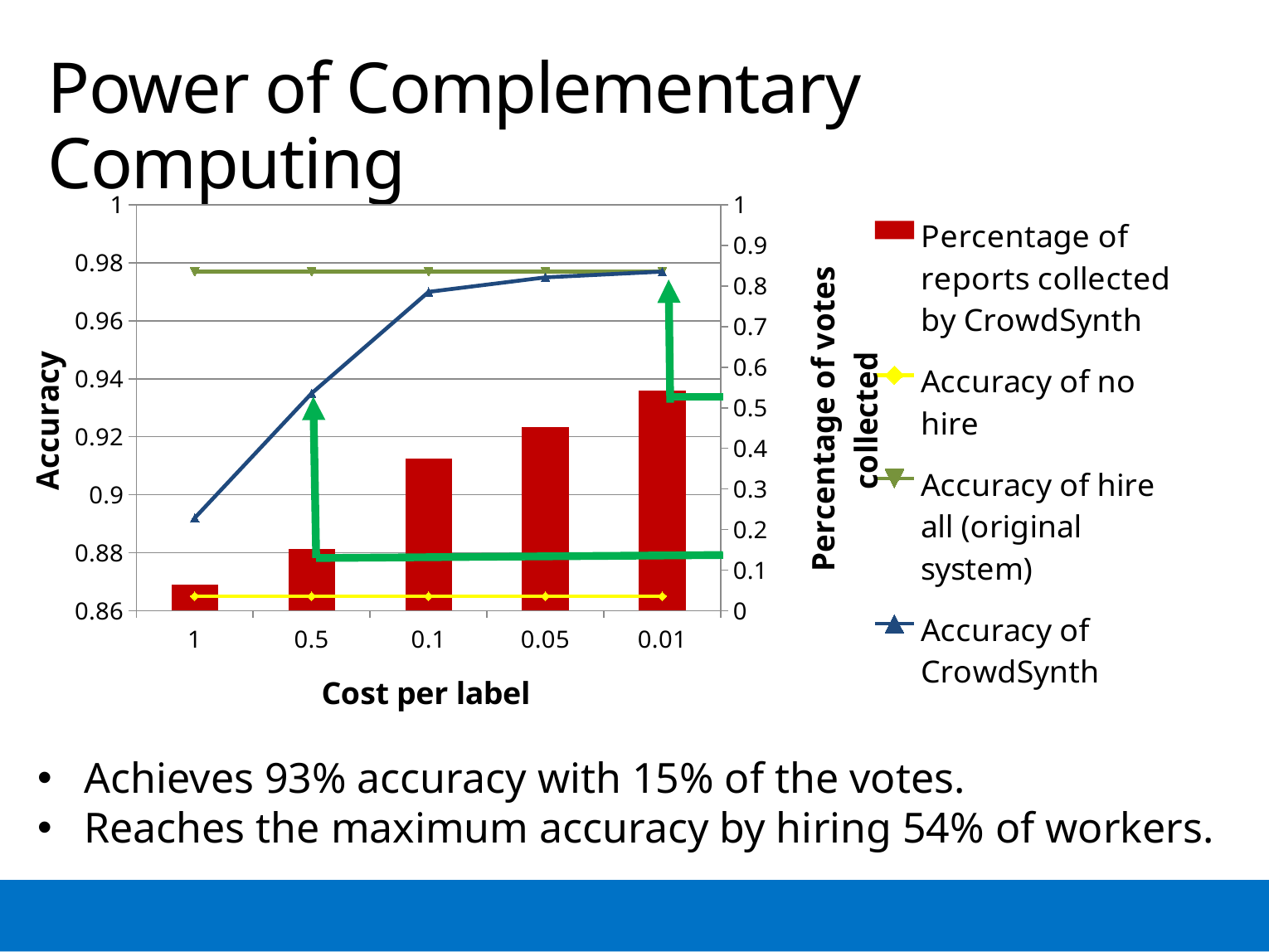
Does the Accuracy of CrowdSynth line rise or fall from left to right along the x axis? rise At which cost per label is the bar for Percentage of reports collected by CrowdSynth highest? 0.01 What is the title of the x axis? Cost per label Is the Accuracy of CrowdSynth at cost per label 1 greater or less than 0.9? less Is the Percentage of reports collected by CrowdSynth at cost per label 0.01 greater or less than 0.4 on the right axis? greater At which cost per label is the bar for Percentage of reports collected by CrowdSynth lowest? 1 At cost per label 0.5, which is higher: Accuracy of CrowdSynth or Accuracy of no hire? Accuracy of CrowdSynth Do the bars for Percentage of reports collected by CrowdSynth rise or fall from left to right along the x axis? rise Is the Percentage of reports collected by CrowdSynth at cost per label 1 greater or less than 0.1 on the right axis? less How many series does the legend list? 4 How many cost-per-label categories are shown on the x axis? 5 What kind of chart is this? Combined bar and line chart